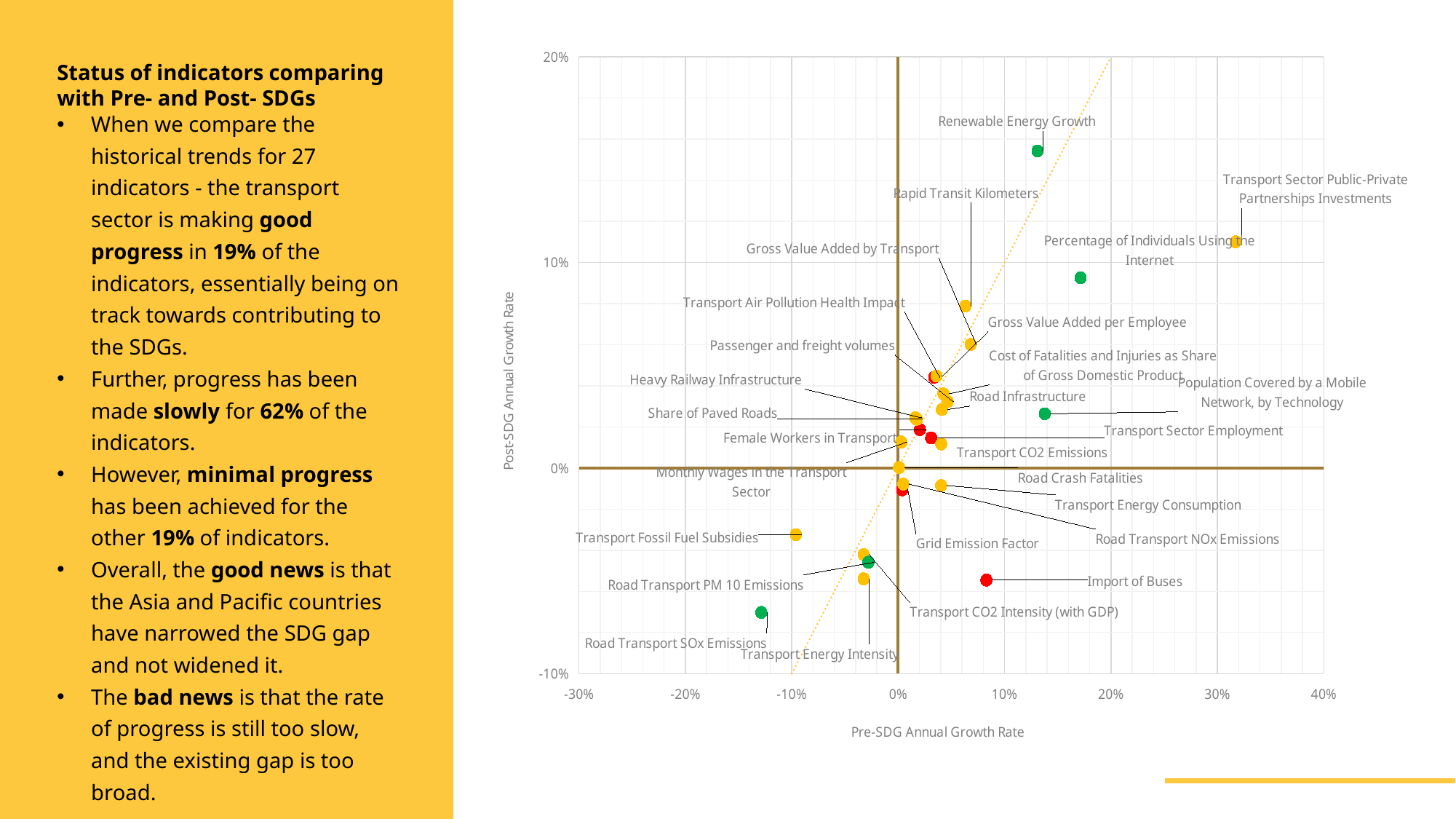
Is the Pre-SDG Annual Growth Rate for Road Transport SOx Emissions greater or less than -10%? less Is the Post-SDG Annual Growth Rate for Import of Buses greater or less than 0%? less Which indicator has the lowest Post-SDG Annual Growth Rate? Road Transport SOx Emissions Is the Post-SDG Annual Growth Rate for Renewable Energy Growth greater or less than 10%? greater What is the title of the horizontal axis of the chart? Pre-SDG Annual Growth Rate Which indicator has the highest Post-SDG Annual Growth Rate? Renewable Energy Growth Which indicator has the lowest Pre-SDG Annual Growth Rate? Road Transport SOx Emissions What kind of chart is shown on the slide? scatter chart Which indicator has the highest Pre-SDG Annual Growth Rate? Transport Sector Public-Private Partnerships Investments Which has a higher Post-SDG Annual Growth Rate, Renewable Energy Growth or Percentage of Individuals Using the Internet? Renewable Energy Growth What is the title of the vertical axis of the chart? Post-SDG Annual Growth Rate